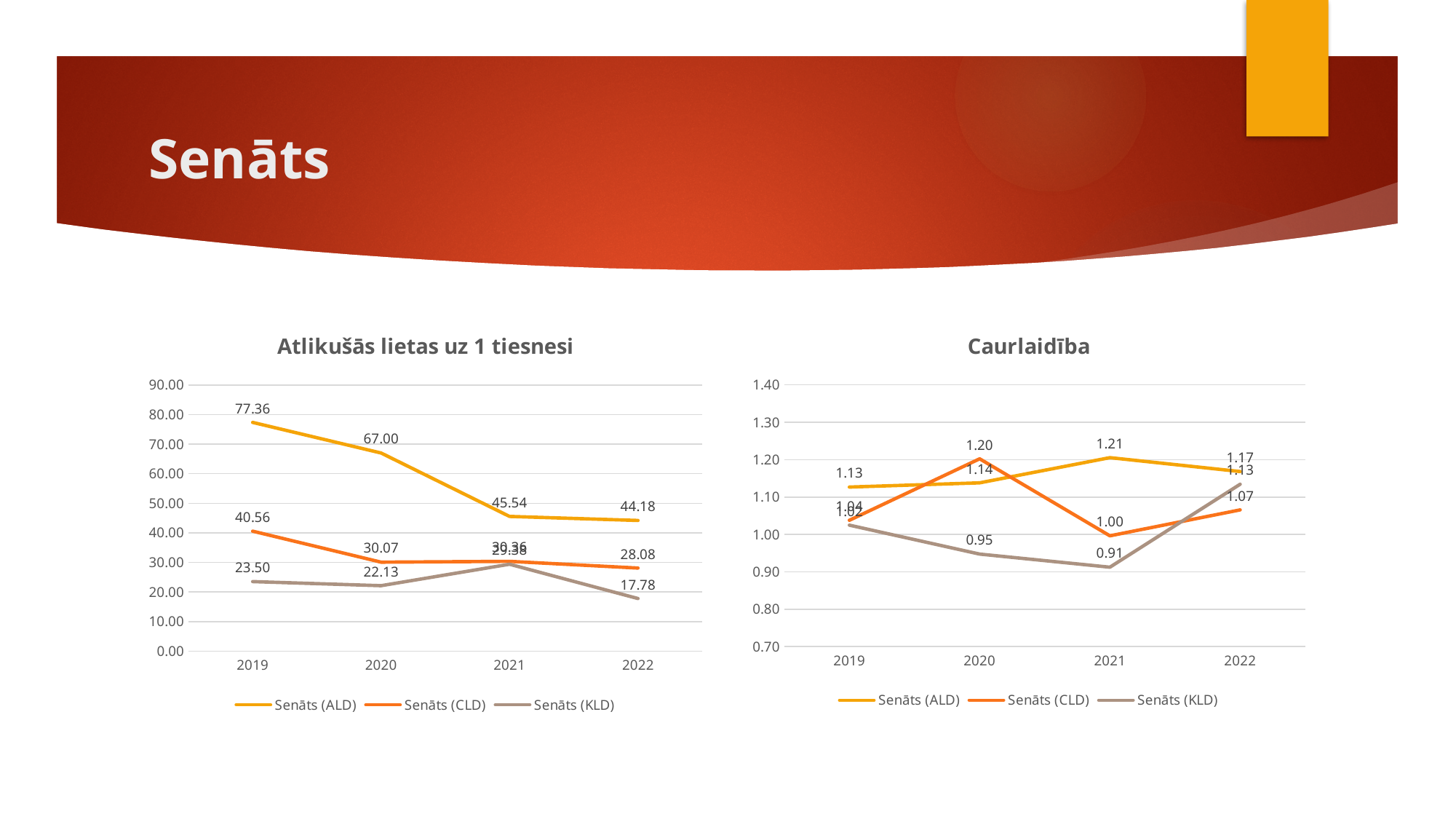
In the chart titled "Atlikušās lietas uz 1 tiesnesi", what is the difference between the Senāts (ALD) values in 2019 and 2020? 10.36 In the chart titled "Caurlaidība", which is larger in 2021: Senāts (ALD) or Senāts (CLD)? Senāts (ALD) In the chart titled "Atlikušās lietas uz 1 tiesnesi", what is the value for Senāts (ALD) in 2019? 77.36 In the chart titled "Caurlaidība", what is the value for Senāts (KLD) in 2021? 0.91 How many series does the legend of the chart titled "Caurlaidība" list? 3 In the chart titled "Atlikušās lietas uz 1 tiesnesi", what is the value for Senāts (CLD) in 2020? 30.07 In the chart titled "Caurlaidība", in which year is the Senāts (KLD) value lowest? 2021 What kind of chart is the chart titled "Atlikušās lietas uz 1 tiesnesi"? line chart In the chart titled "Atlikušās lietas uz 1 tiesnesi", does the Senāts (ALD) line generally rise or fall from 2019 to 2022? fall In the chart titled "Atlikušās lietas uz 1 tiesnesi", what is the value for Senāts (KLD) in 2022? 17.78 In the chart titled "Caurlaidība", what is the value for Senāts (CLD) in 2020? 1.20 In the chart titled "Atlikušās lietas uz 1 tiesnesi", in which year is the Senāts (ALD) value highest? 2019